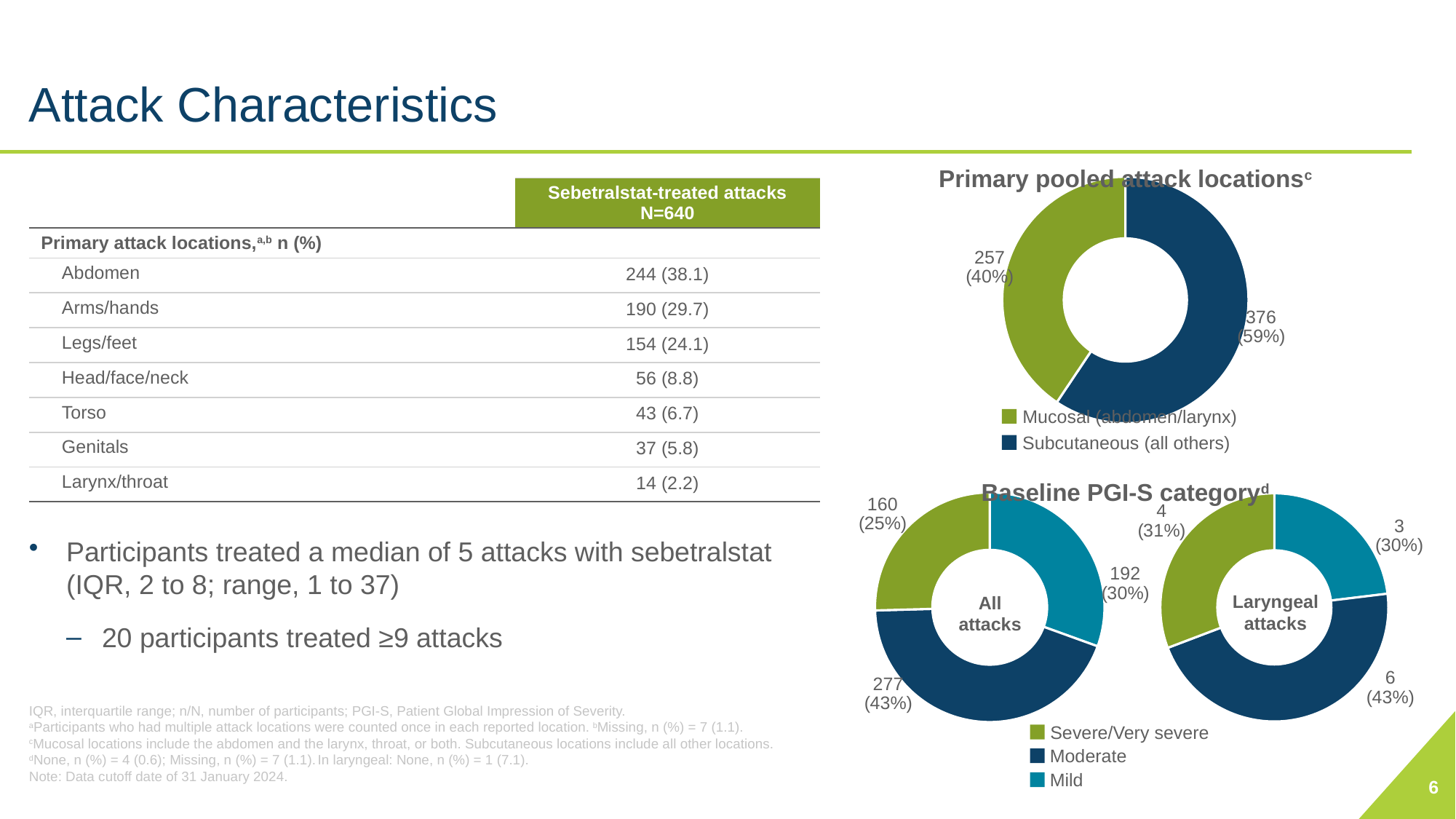
In the 'Baseline PGI-S category' Laryngeal attacks donut, what is the value for Moderate? 6 (43%) In the 'Baseline PGI-S category' Laryngeal attacks donut, which category is the largest? Moderate In the 'Primary pooled attack locations' chart, what is the difference in count between Subcutaneous and Mucosal attacks? 119 In the 'Primary pooled attack locations' chart, which category has the larger share? Subcutaneous (all others) In the 'Primary pooled attack locations' chart, what is the value for Subcutaneous (all others)? 376 (59%) What type of chart is 'Primary pooled attack locations'? Donut (pie) chart In the 'Primary pooled attack locations' chart, what is the value for Mucosal (abdomen/larynx)? 257 (40%) In the 'Baseline PGI-S category' All attacks donut, which category is the smallest? Severe/Very severe In the 'Baseline PGI-S category' All attacks donut, what is the value for Mild? 192 (30%) How many categories does the legend of the 'Baseline PGI-S category' chart list? 3 In the 'Baseline PGI-S category' Laryngeal attacks donut, what is the value for Severe/Very severe? 4 (31%) In the 'Baseline PGI-S category' All attacks donut, what is the value for Moderate? 277 (43%)